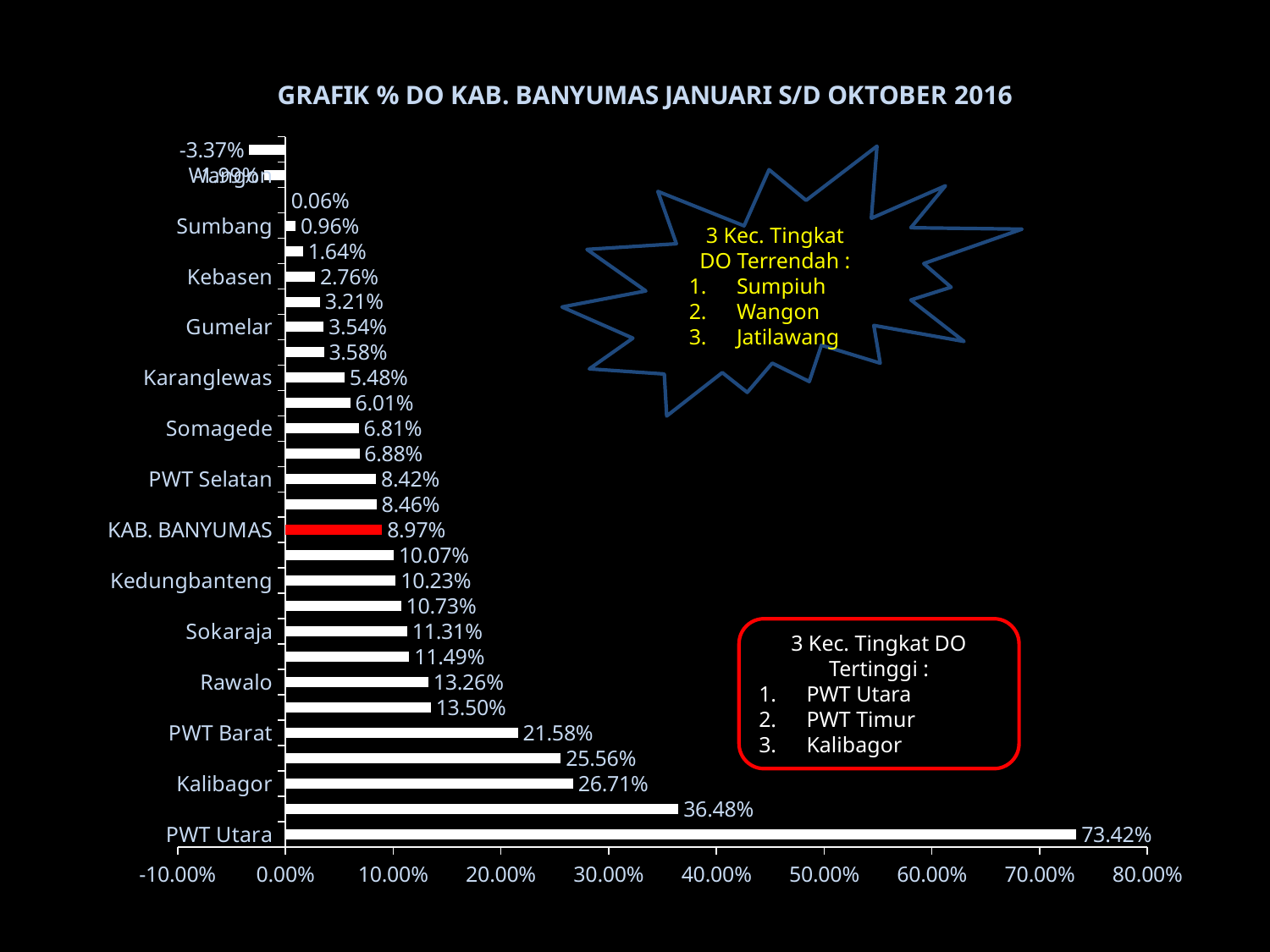
What is the difference between the % DO values of PWT Utara and Kalibagor? 46.71% What is the % DO value for PWT Barat? 21.58% What is the % DO value for PWT Utara? 73.42% What colour is the bar for KAB. BANYUMAS? red What type of chart is shown on the slide? bar chart What is the % DO value for KAB. BANYUMAS? 8.97% What is the title of the chart? GRAFIK % DO KAB. BANYUMAS JANUARI S/D OKTOBER 2016 What is the % DO value for Sokaraja? 11.31% What is the % DO value for Kalibagor? 26.71% Which category has the highest % DO value? PWT Utara Is the value for PWT Utara greater or less than 70.00%? greater Which has a higher % DO value, Kebasen or Gumelar? Gumelar